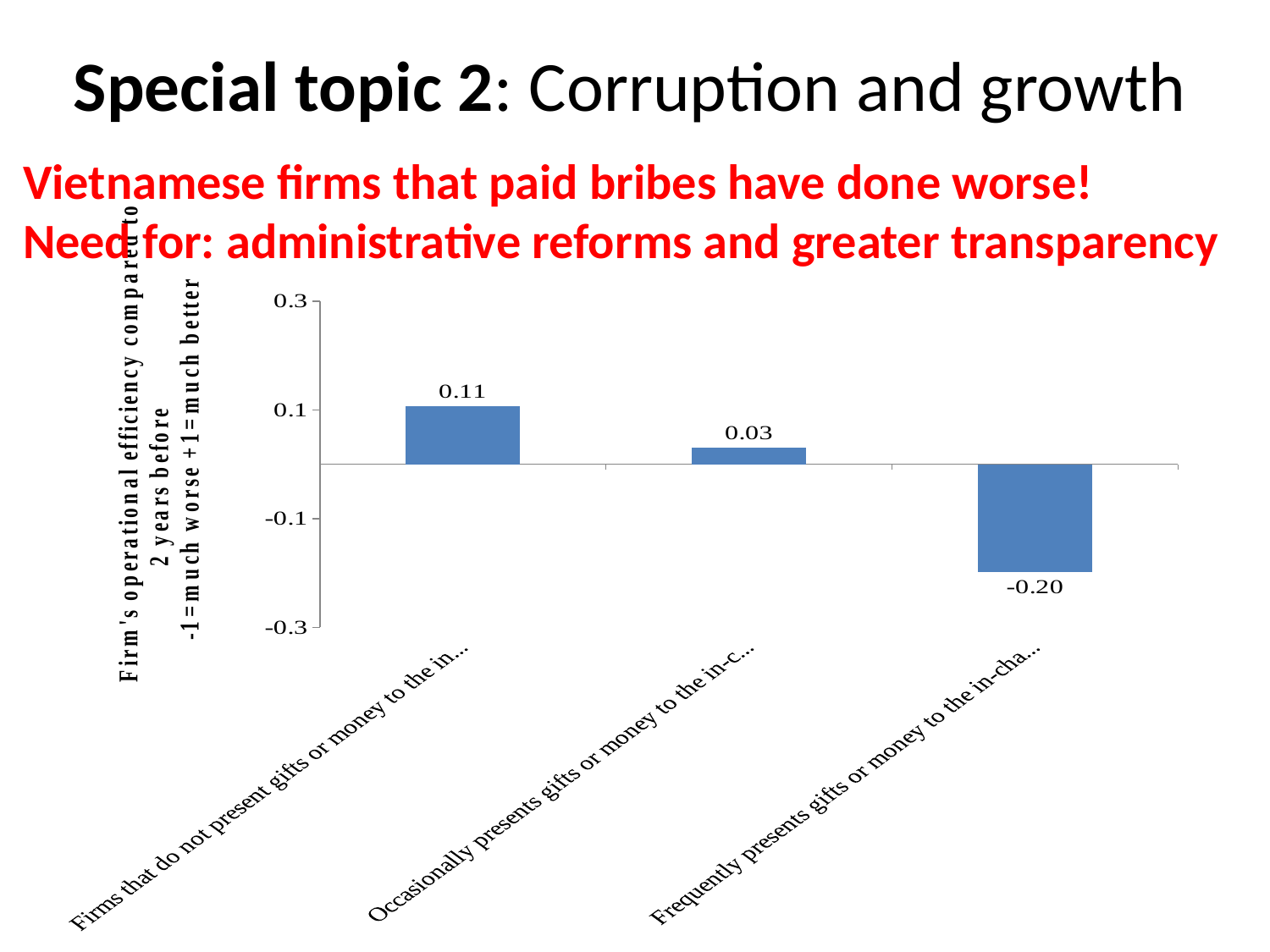
What is the difference between the value for firms that do not present gifts and the value for firms that frequently present gifts? 0.31 Do the values rise or fall from left to right across the categories? Fall What is the value for firms that frequently present gifts or money? -0.20 What is the value for firms that do not present gifts or money? 0.11 What is the difference between the value for firms that do not present gifts and the value for firms that occasionally present gifts? 0.08 What kind of chart is shown on the slide? Bar chart Is the value for firms that frequently present gifts or money greater or less than -0.1? less Which category has the lowest value? Frequently presents gifts or money What is the value for firms that occasionally present gifts or money? 0.03 Which category has the highest value? Firms that do not present gifts or money How many categories are shown in the chart? 3 Which is larger: the value for firms that occasionally present gifts or the value for firms that frequently present gifts? Occasionally presents gifts or money